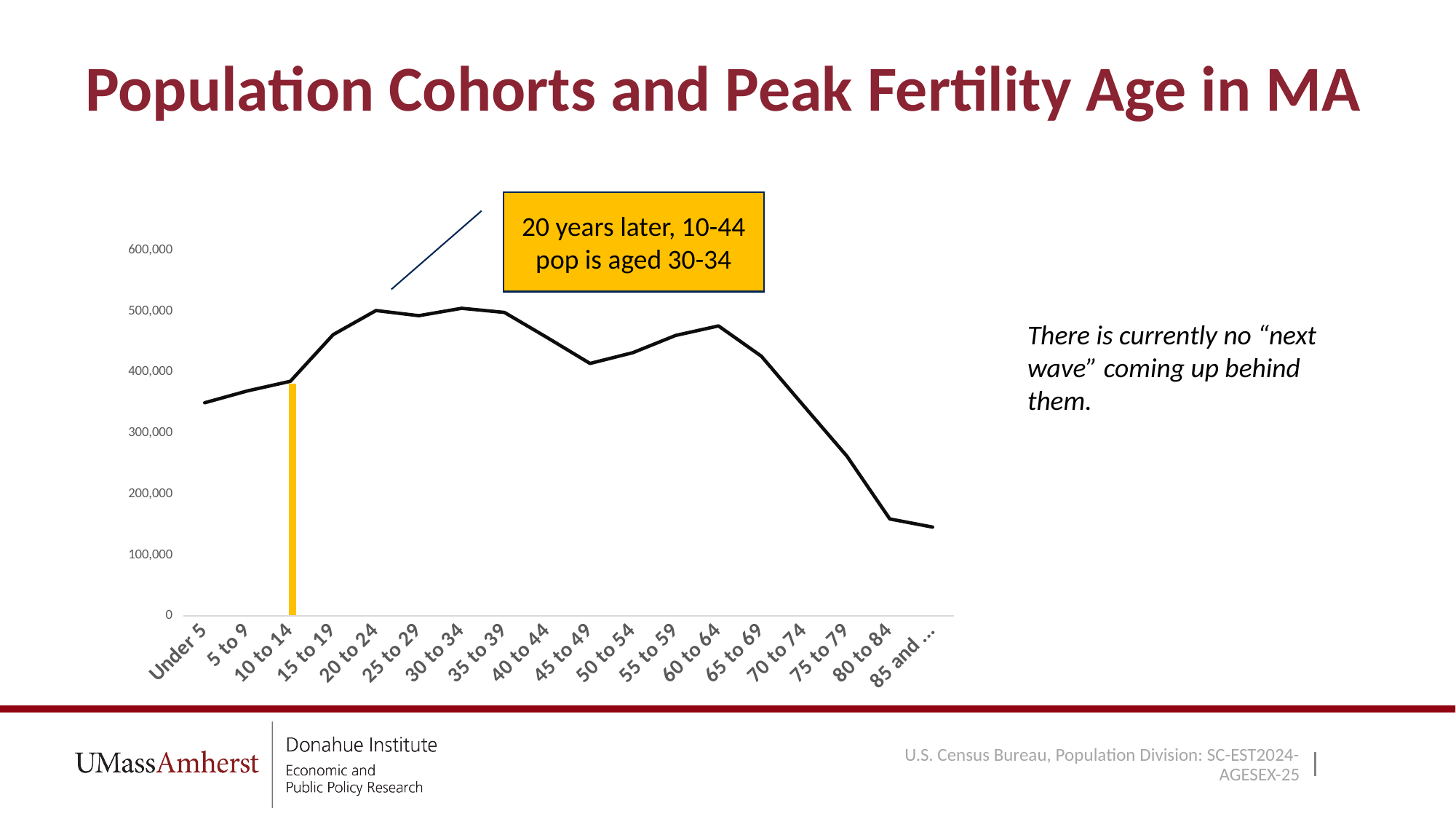
Is the value for 75 to 79 greater or less than 300,000? less Is the value for Under 5 greater or less than 400,000? less What is the title of the slide containing the chart? Population Cohorts and Peak Fertility Age in MA Is the value for 80 to 84 greater or less than 200,000? less What kind of chart is shown on the slide? line chart Which has the larger value, 60 to 64 or 45 to 49? 60 to 64 Do the values rise or fall along the x axis from 65 to 69 through 80 to 84? fall Which age category is marked with a yellow vertical bar on the chart? 10 to 14 Which has the larger value, 20 to 24 or Under 5? 20 to 24 How many age categories are plotted along the x axis? 18